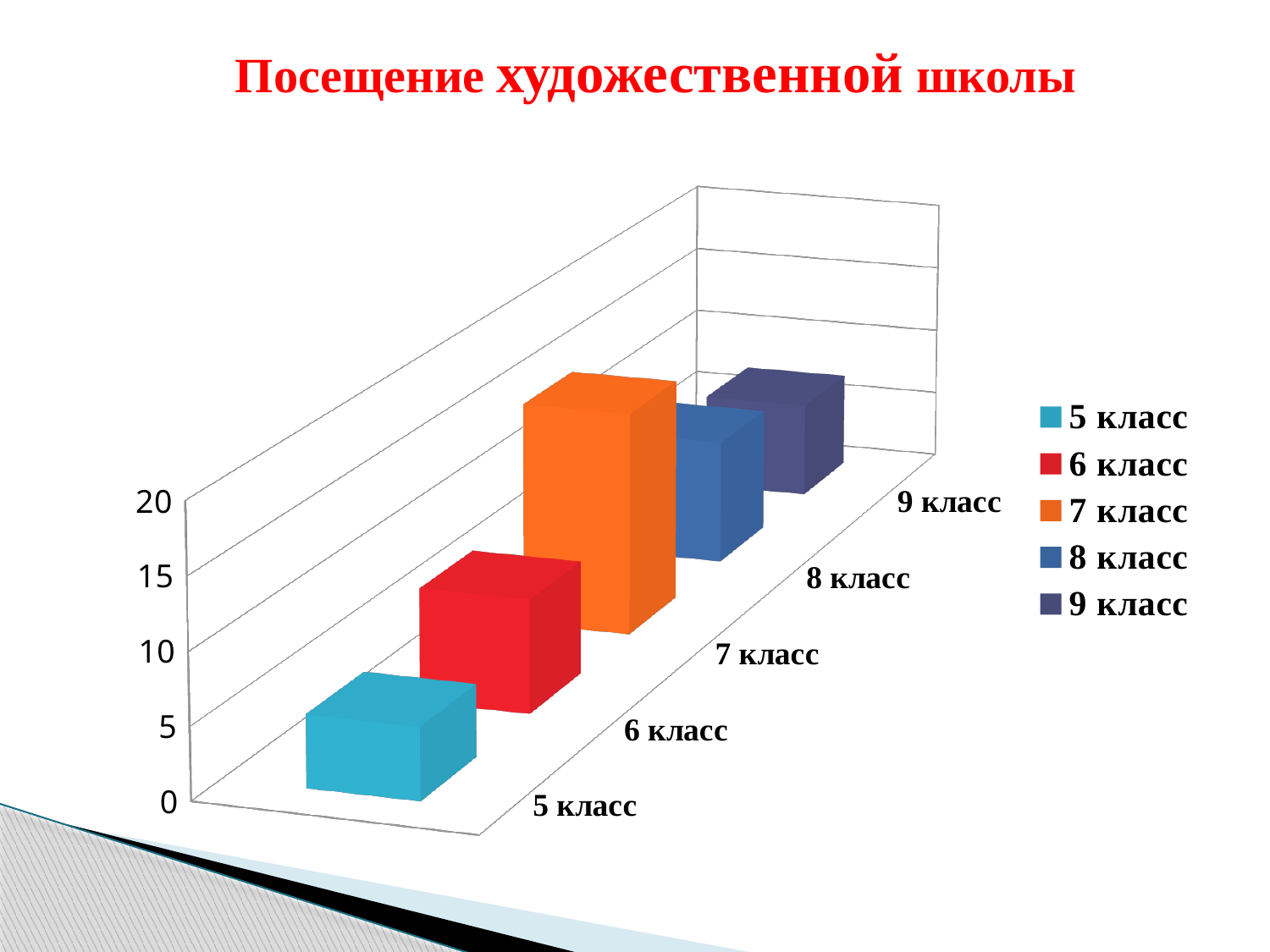
Is the value for 9 класс greater or less than 15? less Which class has the lowest bar? 5 класс Which class has the highest bar? 7 класс Is the value for 5 класс greater or less than 10? less What is the title of the chart? Посещение художественной школы Which is larger, the value for 6 класс or the value for 5 класс? 6 класс Do the values rise or fall from 5 класс to 7 класс? rise Which is larger, the value for 7 класс or the value for 8 класс? 7 класс What kind of chart is shown on the slide? bar chart How many categories (classes) are plotted in the chart? 5 How many entries does the legend list? 5